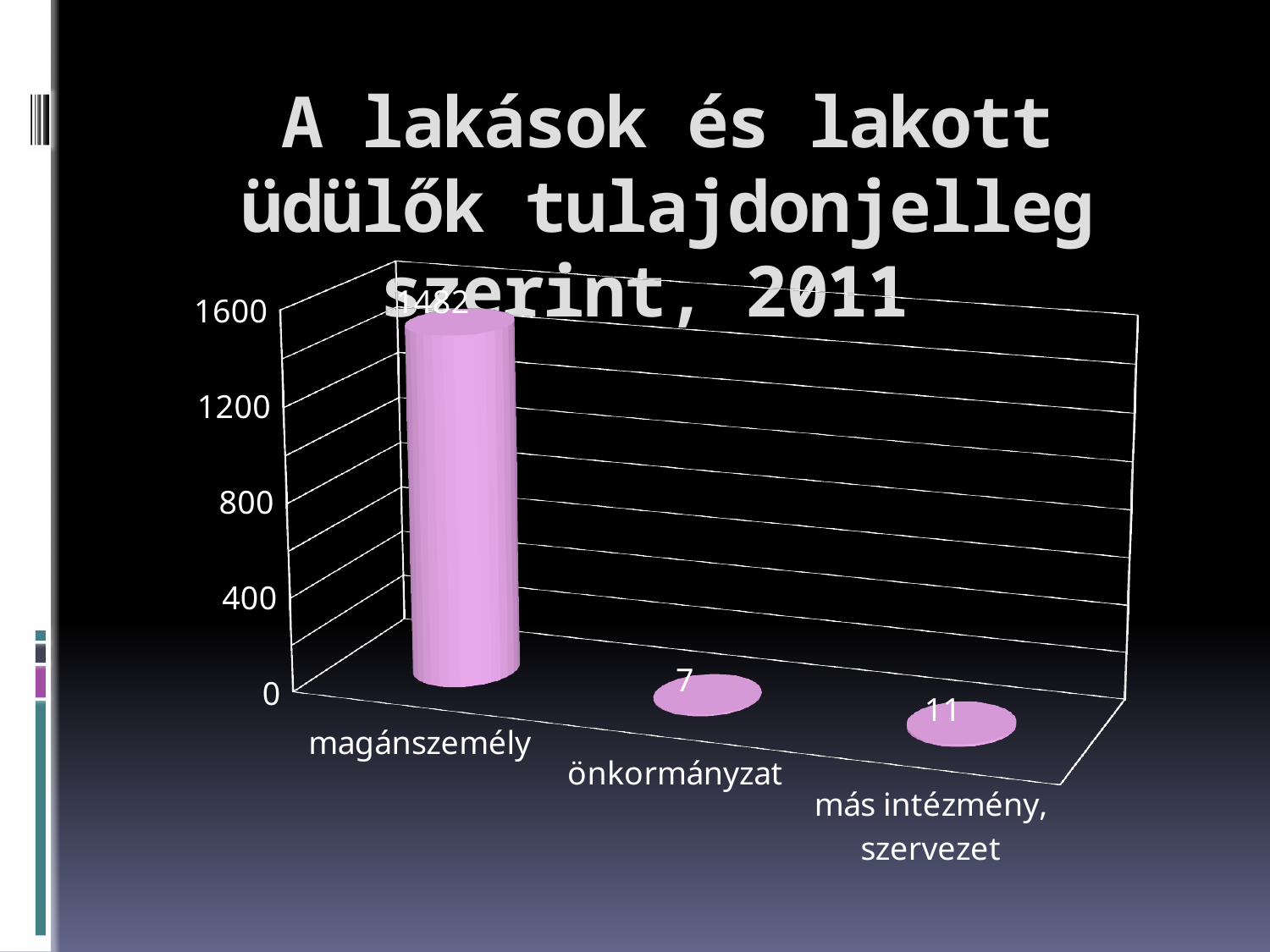
Is the value for önkormányzat greater or less than 400? less What is the value for önkormányzat? 7 How many categories are shown on the x axis of the chart? 3 What is the highest value shown on the vertical axis? 1600 Is the value for magánszemély greater or less than 1200? greater Which category has the highest value? magánszemély What is the value for más intézmény, szervezet? 11 What year is mentioned in the chart title? 2011 What kind of chart is shown on the slide? bar chart Which category has the lowest value? önkormányzat What is the difference between the values for más intézmény, szervezet and önkormányzat? 4 Which is larger, the value for önkormányzat or the value for más intézmény, szervezet? más intézmény, szervezet